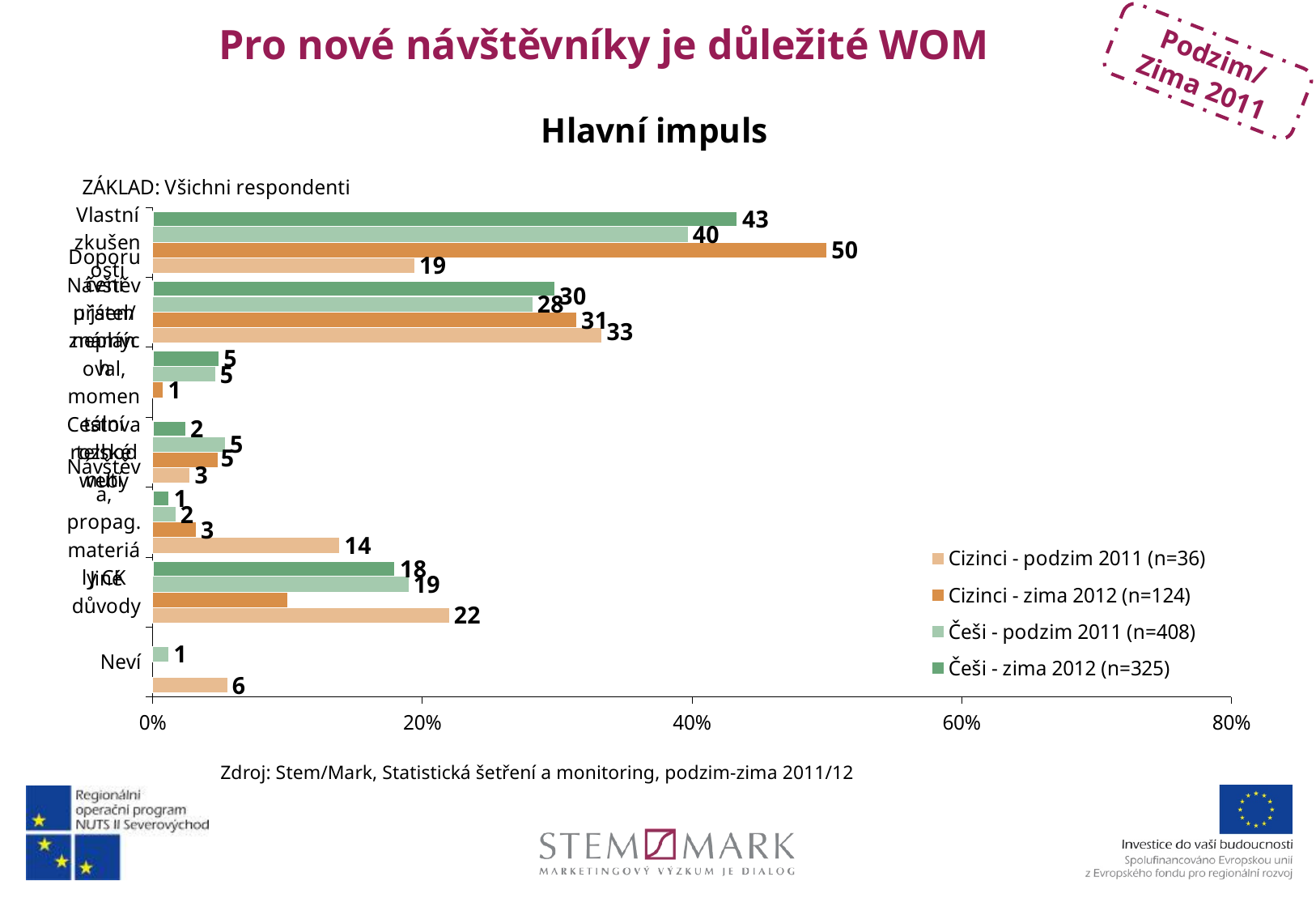
In the topmost category group, which is larger: the value for 'Češi - zima 2012' or for 'Češi - podzim 2011'? Češi - zima 2012 In the 'Jiné důvody' category (second from the bottom), what is the value for 'Cizinci - podzim 2011'? 22 In the 'Jiné důvody' category (second from the bottom), is the value for 'Cizinci - zima 2012' greater or less than 20%? less In the topmost category group, what is the value for 'Cizinci - zima 2012'? 50 In the topmost category group, what is the difference between the values for 'Cizinci - zima 2012' and 'Cizinci - podzim 2011'? 31 What is the value for 'Cizinci - podzim 2011' in the 'Neví' category? 6 According to the legend, what is the sample size (n) for 'Češi - zima 2012'? n=325 What type of chart is shown on the slide? bar chart What is the largest value labelled anywhere on the chart? 50 How many series does the legend of the chart list? 4 What is the highest value shown on the x axis of the chart? 80% What is the value for 'Češi - podzim 2011' in the 'Neví' category? 1